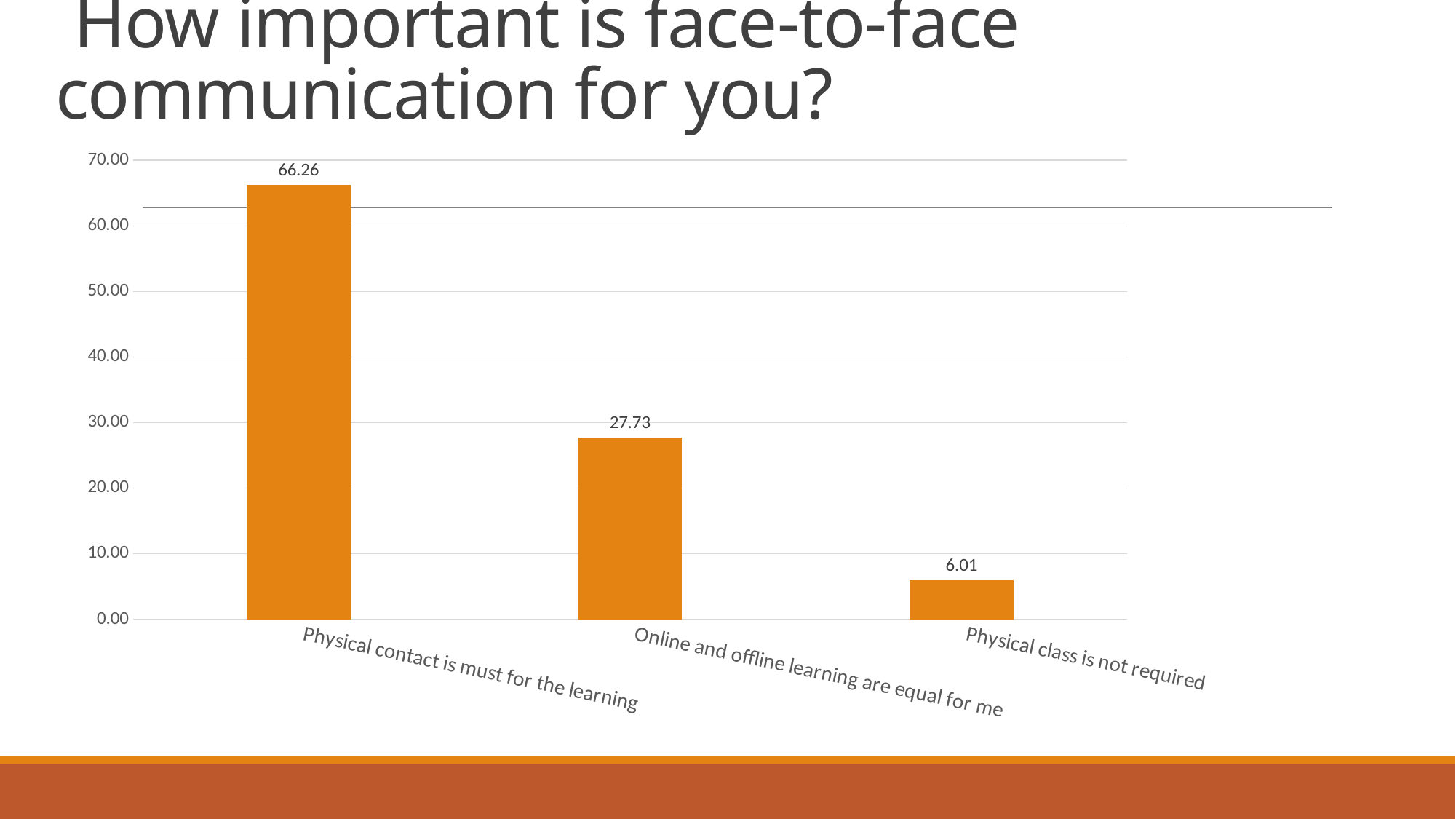
What is the difference between the values for "Physical contact is must for the learning" and "Online and offline learning are equal for me"? 38.53 Which is larger: the value for "Online and offline learning are equal for me" or "Physical class is not required"? Online and offline learning are equal for me Which category has the lowest value? Physical class is not required What is the difference between the values for "Online and offline learning are equal for me" and "Physical class is not required"? 21.72 What kind of chart is shown on the slide? bar chart What is the value for "Physical contact is must for the learning"? 66.26 What is the value for "Physical class is not required"? 6.01 Is the value for "Physical contact is must for the learning" greater or less than 60.00? greater What is the value for "Online and offline learning are equal for me"? 27.73 How many categories are shown in the chart? 3 What is the title of the slide? How important is face-to-face communication for you? Which category has the highest value? Physical contact is must for the learning